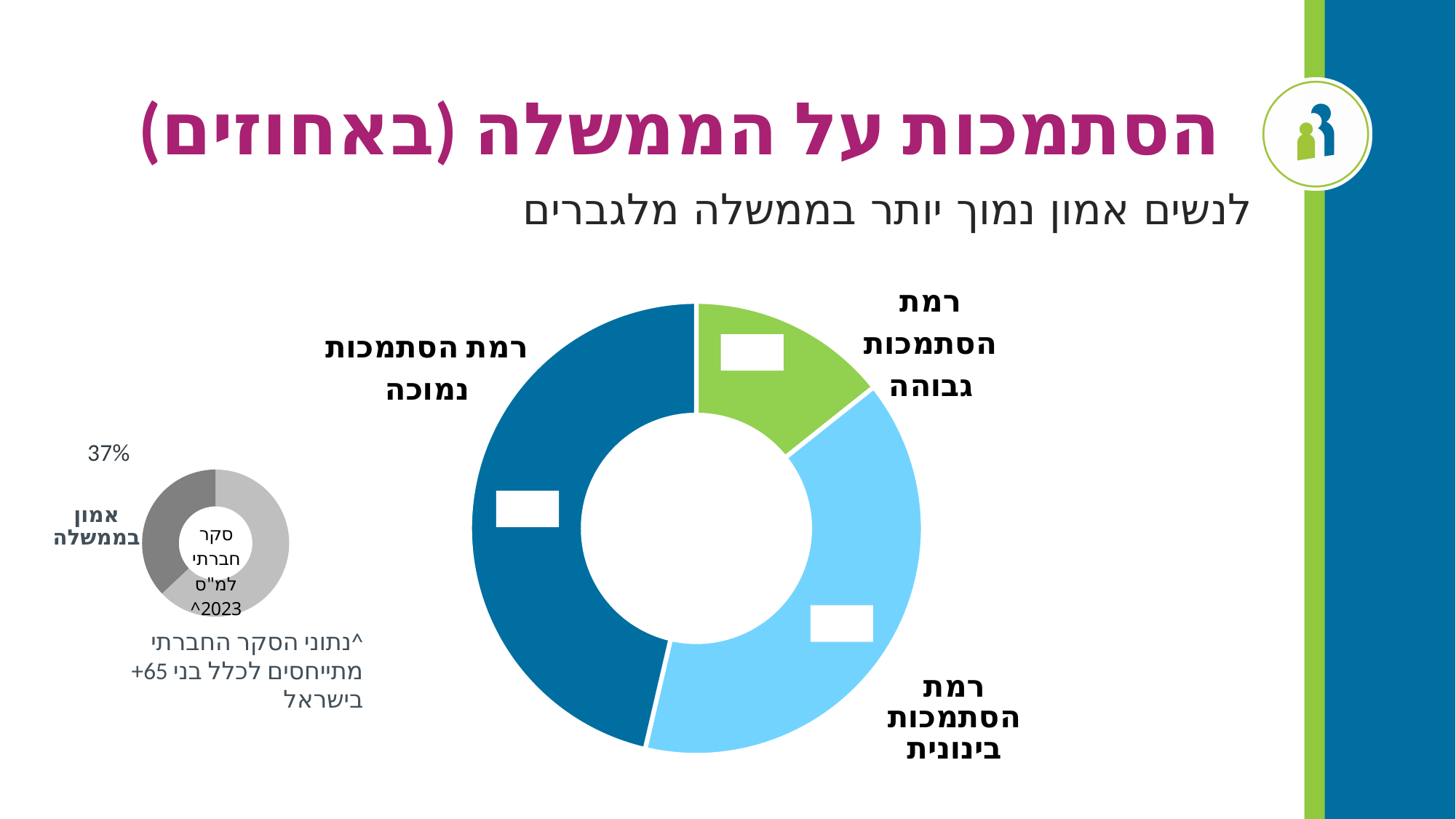
How many segments does the small grey donut chart on the left have? 2 In the small grey donut chart on the left, what percentage is shown for אמון בממשלה? 37% In the large donut chart, what colour is the segment for רמת הסתמכות גבוהה? Green In the large donut chart, what colour is the segment for רמת הסתמכות בינונית? Light blue In the large donut chart, which segment is larger: רמת הסתמכות בינונית or רמת הסתמכות גבוהה? רמת הסתמכות בינונית How many segments does the large donut chart have? 3 In the large donut chart, which category has the smallest segment? רמת הסתמכות גבוהה In the large donut chart, which category has the largest segment? רמת הסתמכות נמוכה In the large donut chart, which segment is larger: רמת הסתמכות נמוכה or רמת הסתמכות גבוהה? רמת הסתמכות נמוכה What kind of chart is the large chart in the centre of the slide? Donut (pie) chart What kind of chart is the small grey chart on the left of the slide? Donut (pie) chart